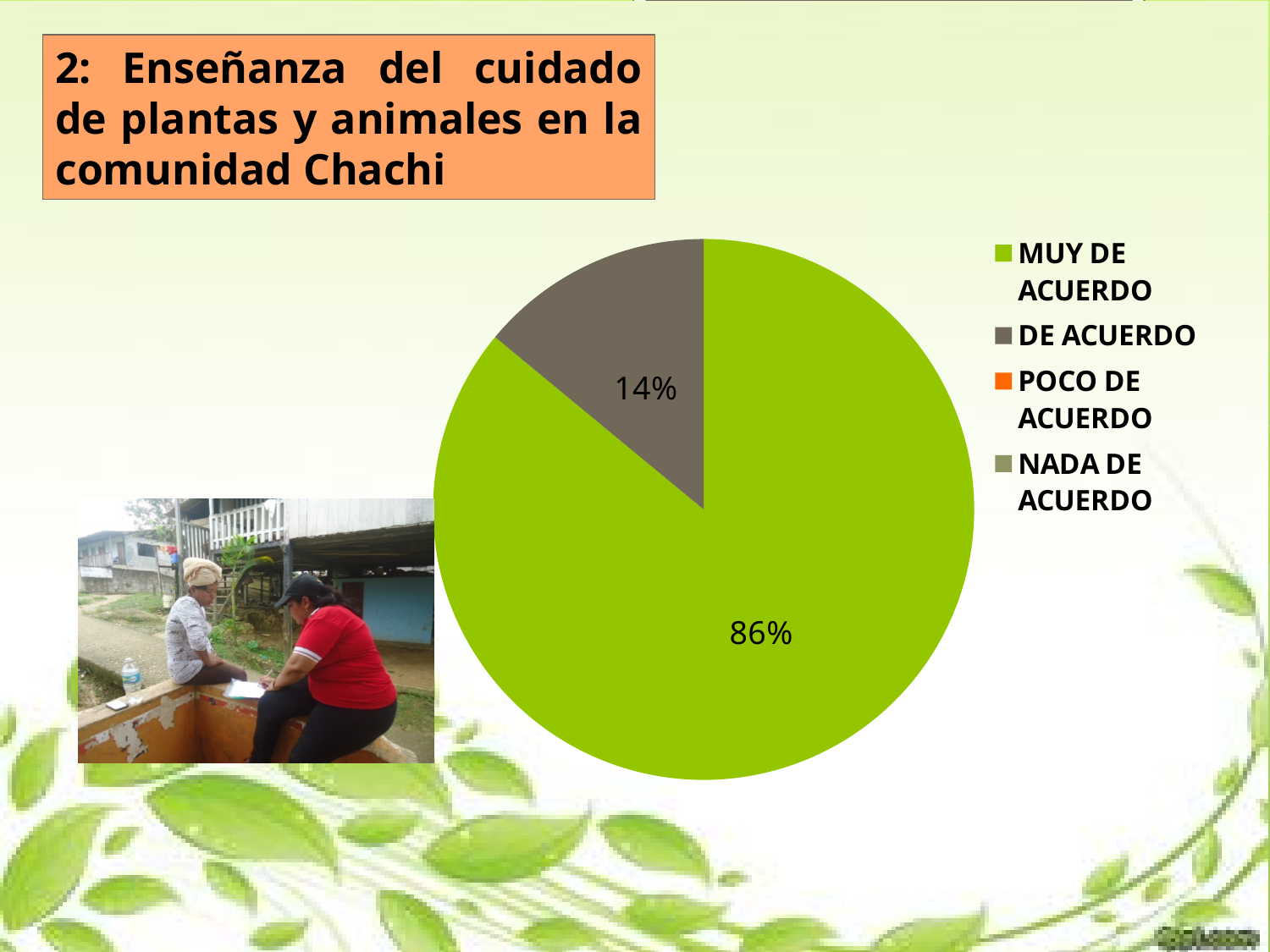
What is the difference in percentage points between the MUY DE ACUERDO and DE ACUERDO slices? 72 Which legend entry is shown in orange? POCO DE ACUERDO What percentage of the pie corresponds to MUY DE ACUERDO? 86% What percentage of the pie corresponds to DE ACUERDO? 14% Which category has the largest share of the pie? MUY DE ACUERDO How many entries does the legend list? 4 How many slices with data labels are visible in the pie? 2 What is the combined share of the MUY DE ACUERDO and DE ACUERDO slices? 100% Which of the two visible slices is larger, MUY DE ACUERDO or DE ACUERDO? MUY DE ACUERDO What colour is the MUY DE ACUERDO slice? green What kind of chart is shown on the slide? pie chart